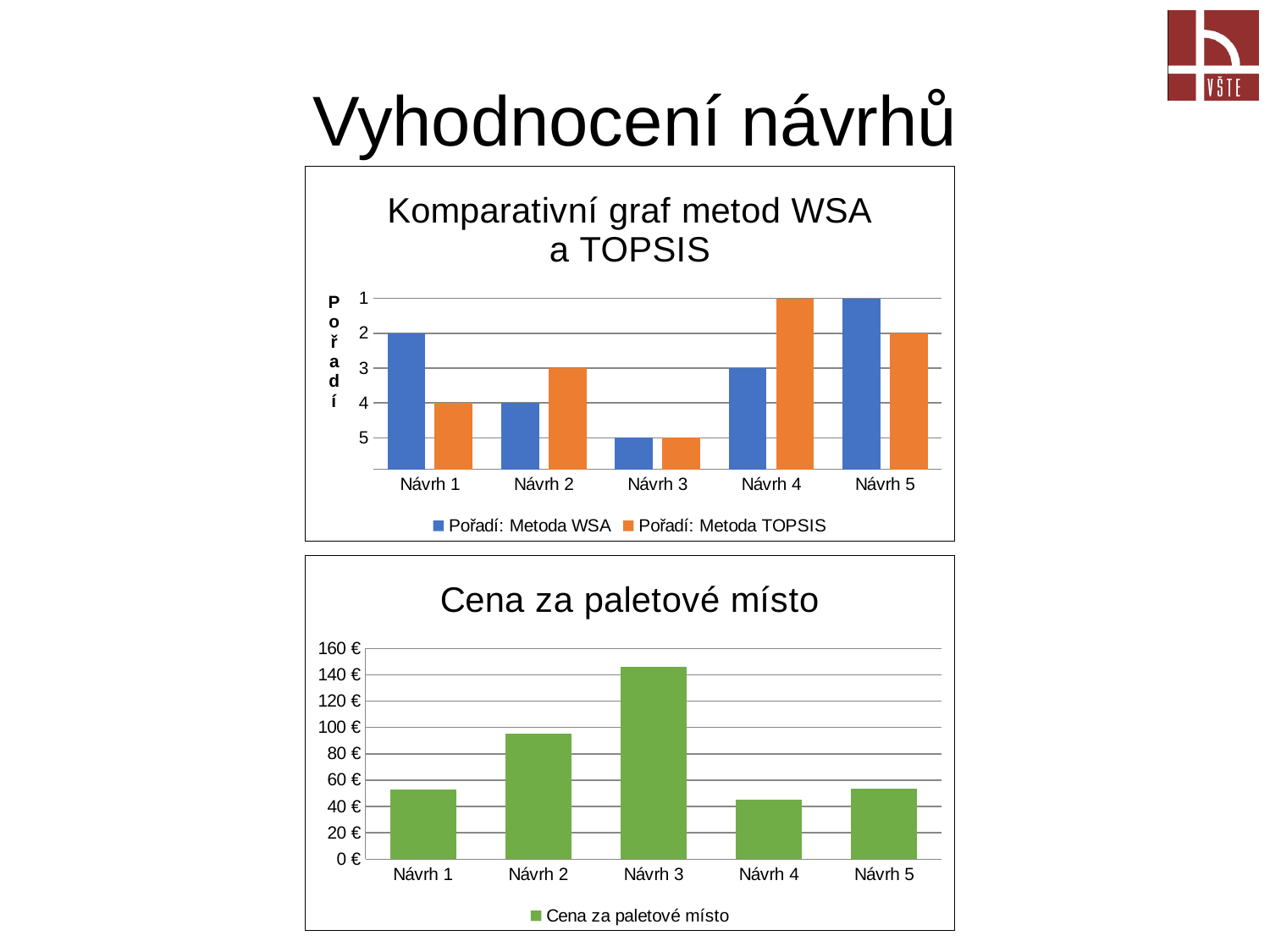
In the chart 'Komparativní graf metod WSA a TOPSIS', what rank does Návrh 1 receive under Pořadí: Metoda WSA? 2 In the chart 'Komparativní graf metod WSA a TOPSIS', how many series does the legend list? 2 In the chart 'Cena za paletové místo', which návrh has the highest price? Návrh 3 In the chart 'Komparativní graf metod WSA a TOPSIS', how many návrhy are shown on the x axis? 5 In the chart 'Cena za paletové místo', is the value for Návrh 2 greater or less than 100 €? less What kind of chart is 'Cena za paletové místo'? bar chart In the chart 'Komparativní graf metod WSA a TOPSIS', what rank does Návrh 4 receive under Pořadí: Metoda TOPSIS? 1 In the chart 'Komparativní graf metod WSA a TOPSIS', what rank does Návrh 2 receive under Pořadí: Metoda TOPSIS? 3 In the chart 'Cena za paletové místo', is the value for Návrh 3 greater or less than 140 €? greater In the chart 'Cena za paletové místo', which návrh has the lowest price? Návrh 4 In the chart 'Komparativní graf metod WSA a TOPSIS', what rank does Návrh 3 receive under Pořadí: Metoda WSA? 5 In the chart 'Komparativní graf metod WSA a TOPSIS', which návrh is ranked 1 by Pořadí: Metoda WSA? Návrh 5